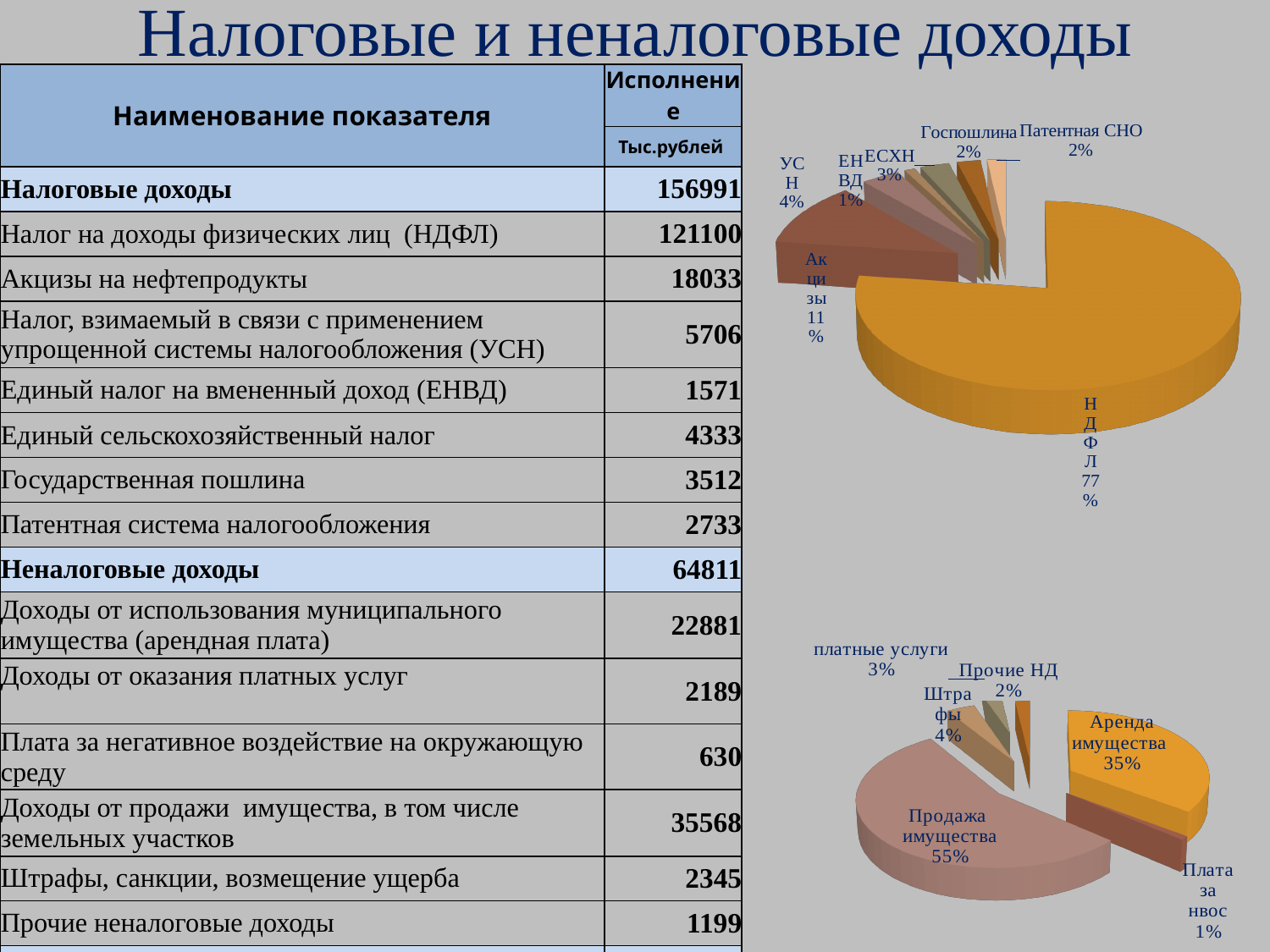
In the bottom pie chart, which slice is the largest? Продажа имущества In the top pie chart, what is the difference between the shares of НДФЛ and Акцизы? 66% In the top pie chart, which slice is the smallest? ЕНВД In the bottom pie chart, which is larger: Штрафы or платные услуги? Штрафы In the top pie chart, what share does Акцизы have? 11% In the bottom pie chart, what share does Аренда имущества have? 35% In the top pie chart, what share does НДФЛ have? 77% What type of chart is the bottom chart on the slide? Pie chart In the top pie chart, how many slices are labelled? 7 In the top pie chart, which slice is the largest? НДФЛ In the bottom pie chart, which slice is the smallest? Плата за нвос